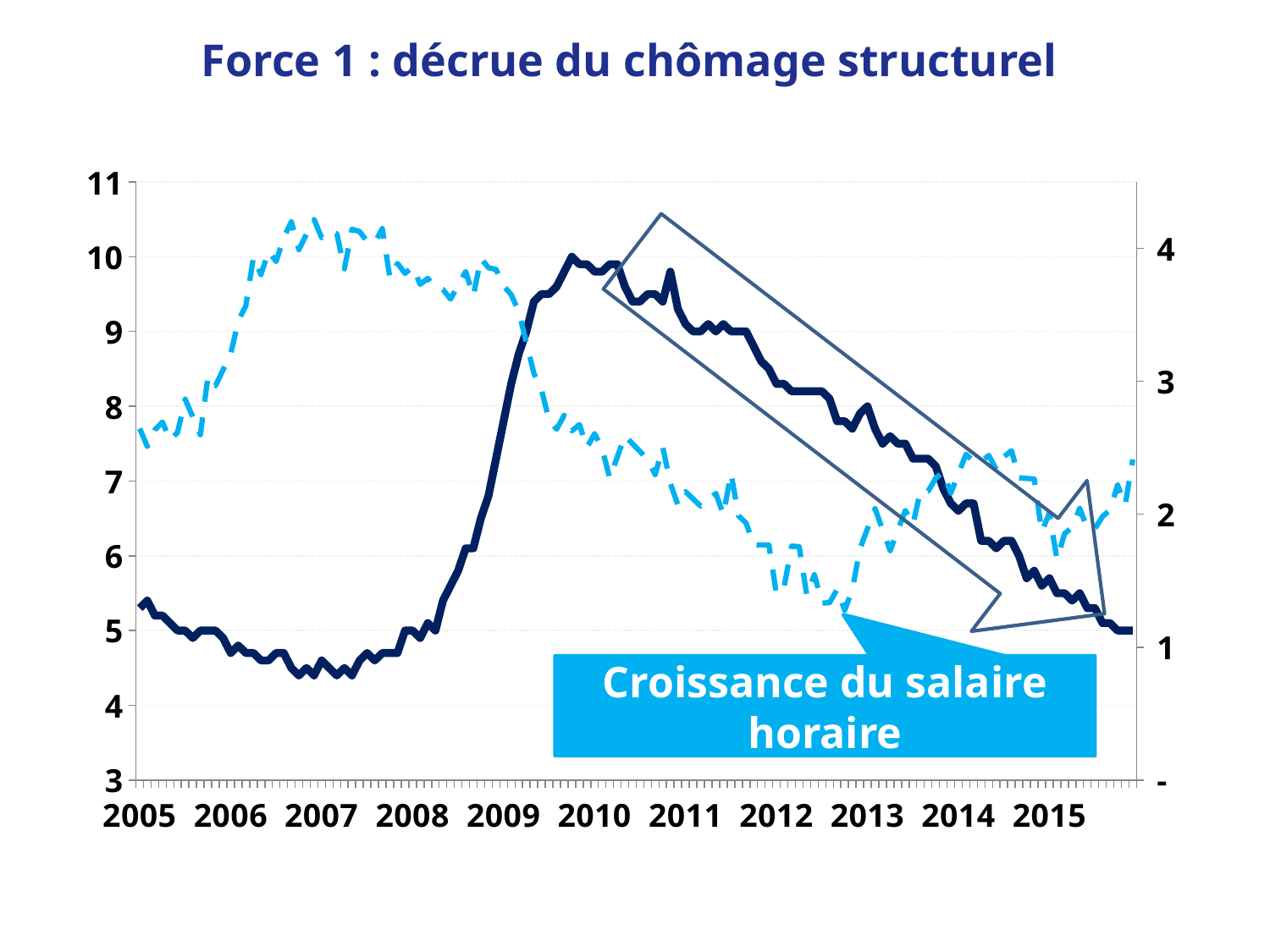
What kind of chart is shown on the slide? line chart Does the dashed light blue line (Croissance du salaire horaire) rise or fall between 2005 and 2007? rise Does the solid dark blue line rise or fall between 2008 and 2010? rise On the right axis, is the value of the dashed light blue line (Croissance du salaire horaire) at the start of 2012 greater or less than 2? less What is the title of the slide? Force 1 : décrue du chômage structurel Does the dashed light blue line (Croissance du salaire horaire) rise or fall between 2007 and 2012? fall On the left axis, is the value of the solid dark blue line at the start of 2007 greater or less than 5? less On the right axis, is the value of the dashed light blue line (Croissance du salaire horaire) at the start of 2007 greater or less than 3? greater How many year labels are shown on the x axis? 11 Which series does the light blue callout label identify? Croissance du salaire horaire